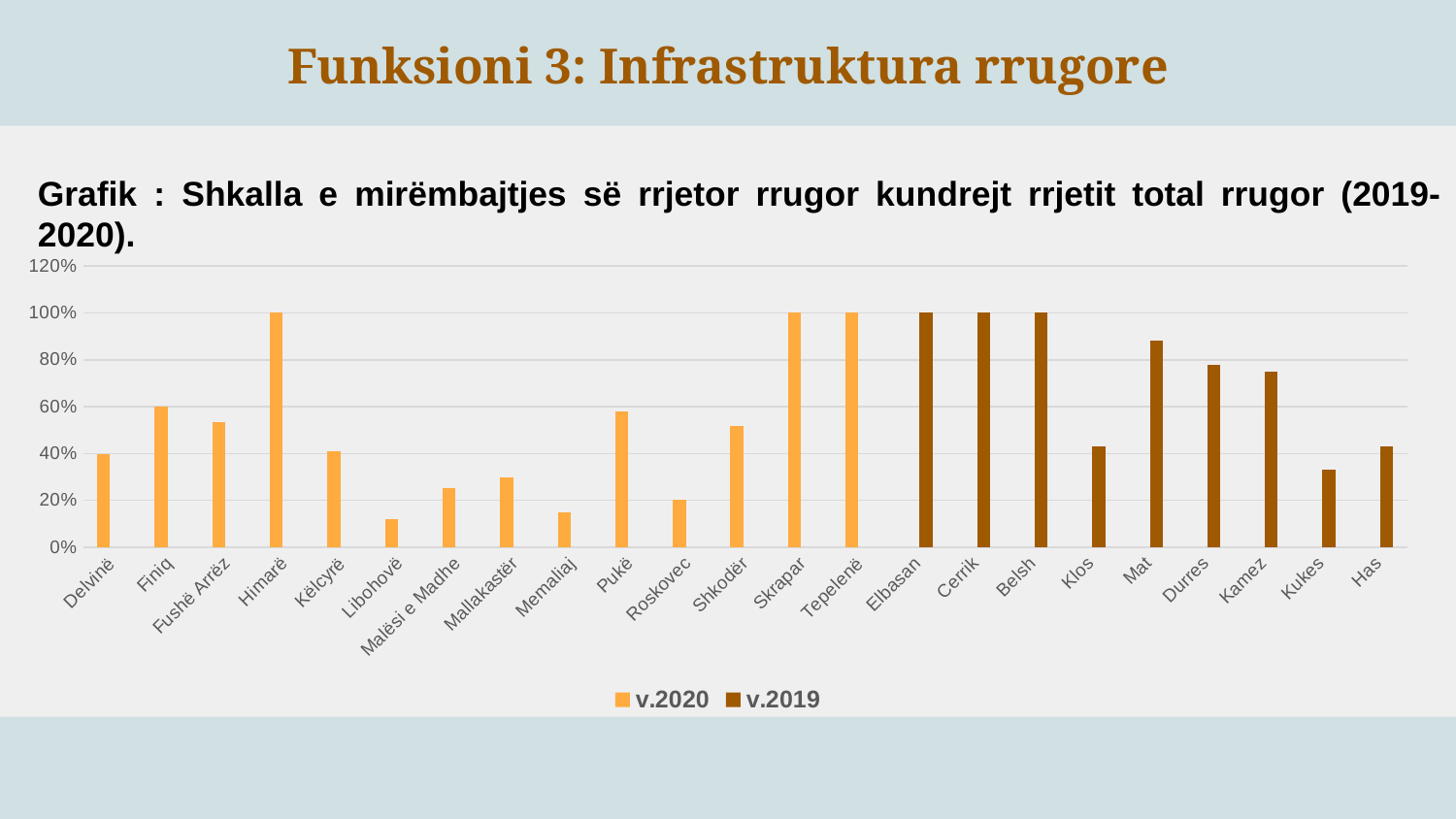
What is the value for Elbasan? 100% Which series is shown in the darker brown colour? v.2019 How many series does the legend list? 2 Which has the larger value, Finiq or Delvinë? Finiq Is the value for Kukes greater or less than 40%? less Which municipality has the lowest value on the chart? Libohovë How many municipalities (categories) are shown on the x axis? 23 Which has the larger value, Mat or Klos? Mat What is the value for Himarë? 100% What kind of chart is shown on the slide? Bar chart Is the value for Memaliaj greater or less than 20%? less Is the value for Mat greater or less than 80%? greater